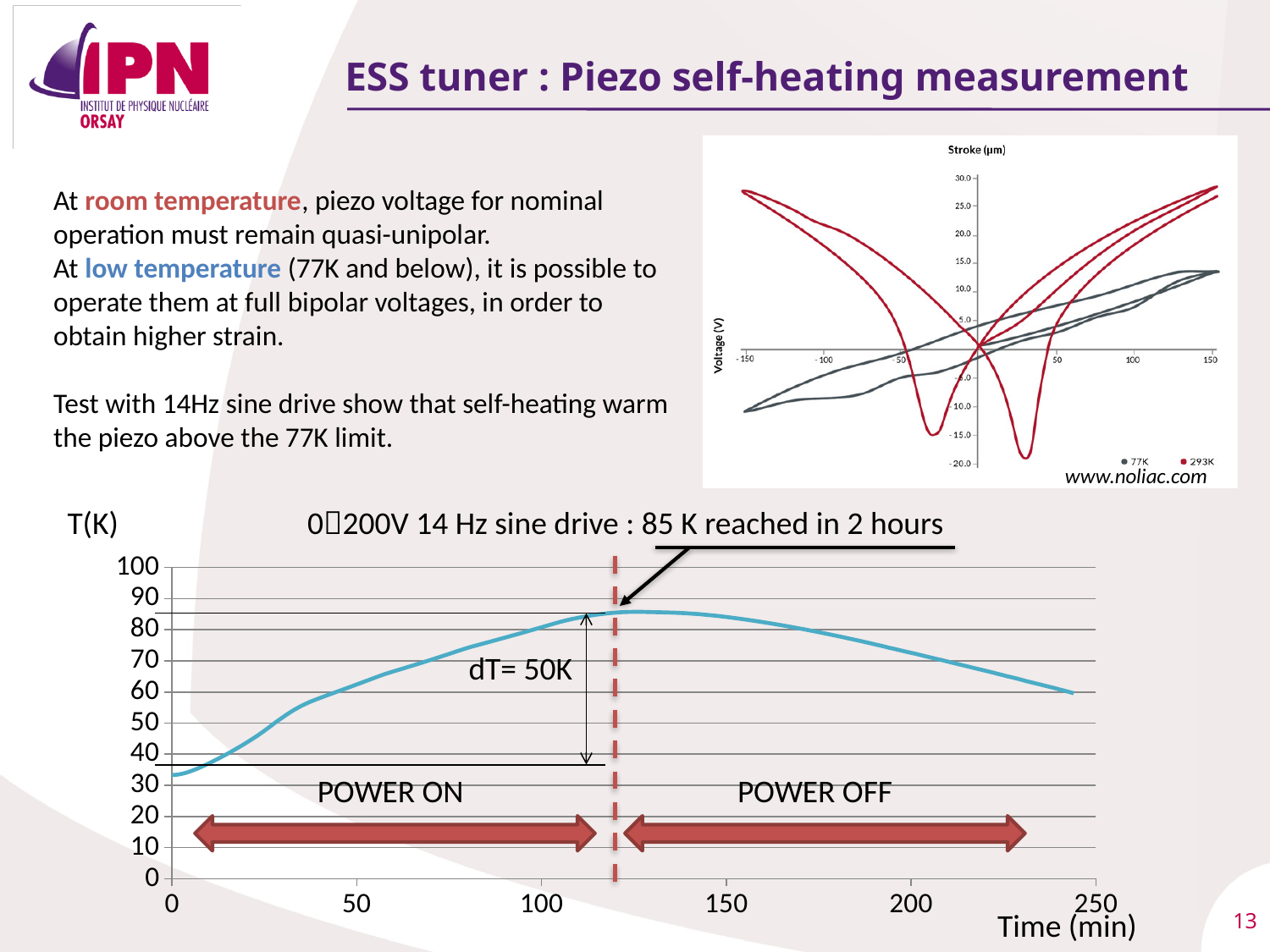
In the bottom chart, what temperature rise (dT) is annotated during the POWER ON phase? 50K In the bottom chart, does the temperature rise or fall between 150 and 250 minutes? fall In the top-right Stroke versus Voltage chart, which series reaches the higher stroke at 150 V, 77K or 293K? 293K In the bottom chart, is the temperature at 0 minutes greater or less than 40? less In the bottom chart, is the temperature at 50 minutes greater or less than 50? greater What kind of chart is the large chart at the bottom of the slide (T(K) versus Time)? line chart How many series does the legend of the top-right Stroke versus Voltage chart list? 2 In the bottom chart, does the temperature rise or fall between 0 and 100 minutes? rise In the bottom chart, what temperature is reached after 2 hours according to the annotation? 85 K In the bottom chart, is the peak temperature greater or less than 90? less What are the two legend entries of the top-right Stroke versus Voltage chart? 77K and 293K What is the x-axis label of the bottom chart? Time (min)